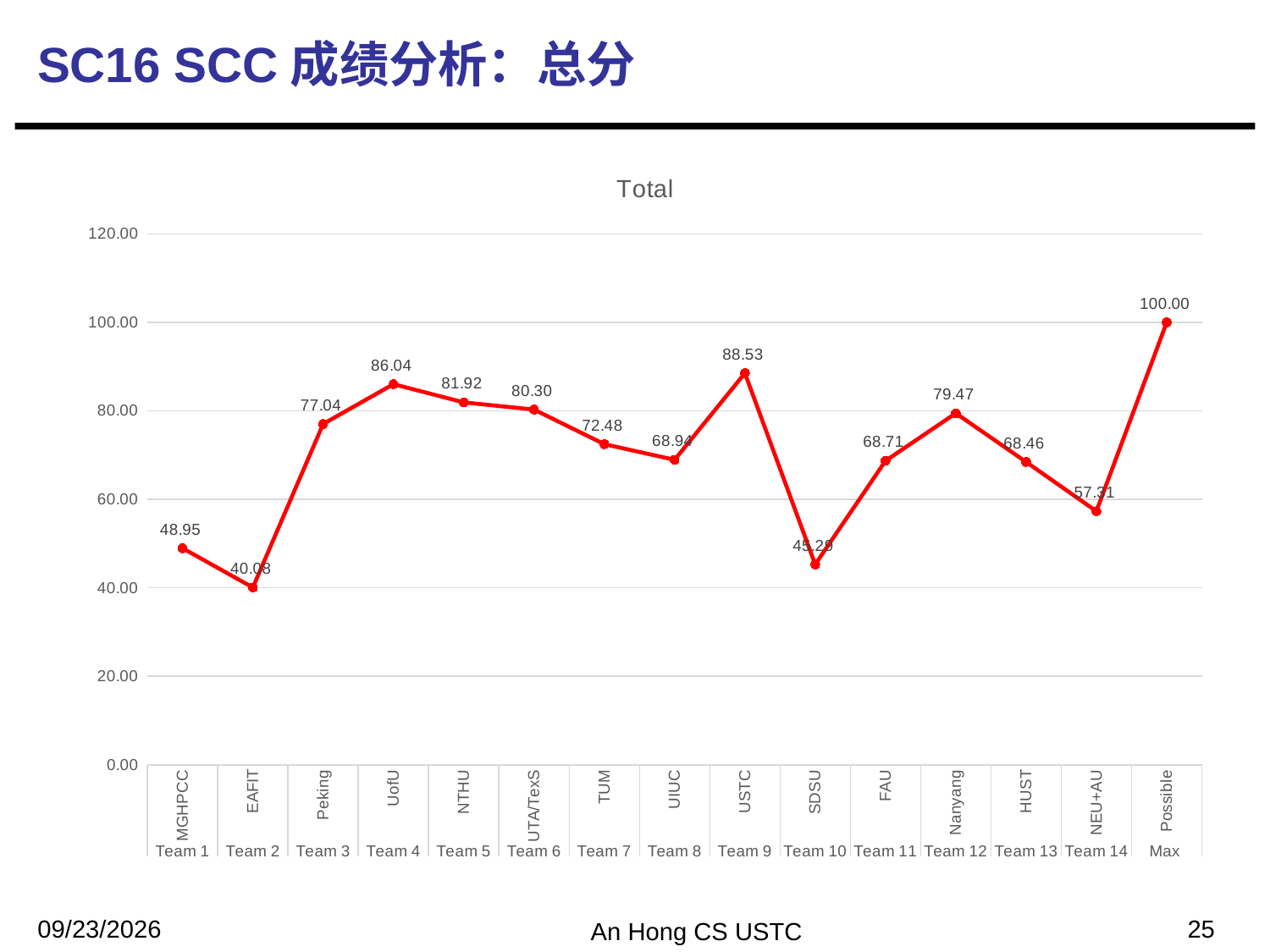
What is the difference between the Total values of USTC (Team 9) and UofU (Team 4)? 2.49 What kind of chart is shown on the slide? line chart What is the Total value for USTC (Team 9)? 88.53 Which has a larger Total value, NTHU (Team 5) or UTA/TexS (Team 6)? NTHU (Team 5) How many data points are plotted on the chart? 15 What is the Total value for UofU (Team 4)? 86.04 What is the Total value for Peking (Team 3)? 77.04 Which category has the highest Total value? Possible (Max) What is the title of the chart? Total Which category has the lowest Total value? EAFIT (Team 2) Is the Total value for SDSU (Team 10) greater or less than 60.00? less What is the Total value for Nanyang (Team 12)? 79.47